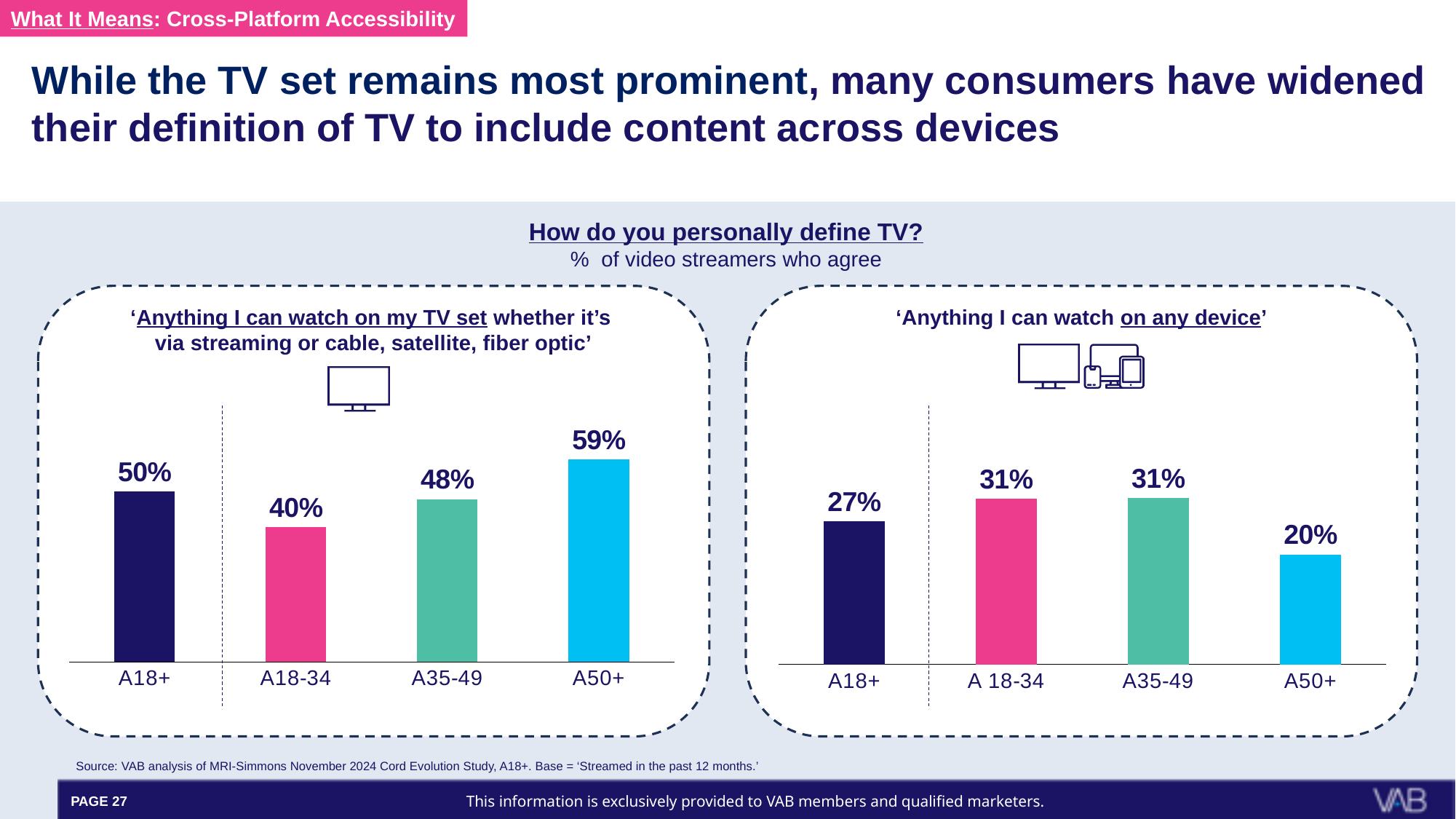
What kind of chart is the right chart ('Anything I can watch on any device')? Bar chart In the right chart ('Anything I can watch on any device'), which age group has the lowest value? A50+ In the left chart ('Anything I can watch on my TV set'), which age group has the highest value? A50+ In the left chart ('Anything I can watch on my TV set'), what is the value for A18-34? 40% In the right chart ('Anything I can watch on any device'), what is the value for A18+? 27% In the right chart ('Anything I can watch on any device'), which is larger: the value for A18+ or the value for A35-49? A35-49 In the left chart ('Anything I can watch on my TV set'), what is the value for A50+? 59% How many age groups are shown in the left chart ('Anything I can watch on my TV set')? 4 In the left chart ('Anything I can watch on my TV set'), which age group has the lowest value? A18-34 In the right chart ('Anything I can watch on any device'), what is the value for A50+? 20% In the right chart ('Anything I can watch on any device'), what is the difference between the A18-34 value and the A50+ value? 11% In the left chart ('Anything I can watch on my TV set'), what is the difference between the A50+ value and the A18-34 value? 19%